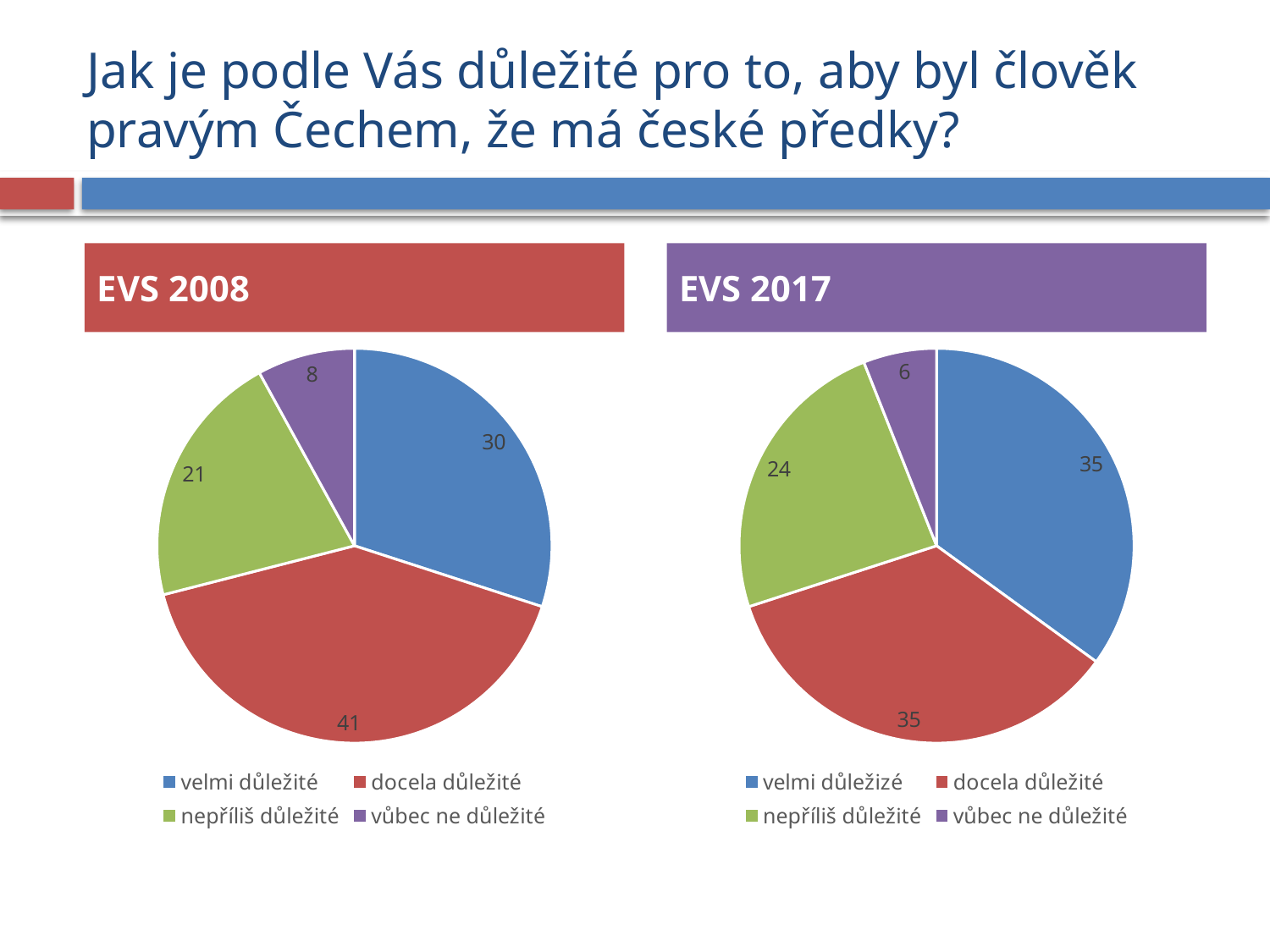
In the EVS 2008 chart, which category has the largest slice? docela důležité In the EVS 2008 chart, what is the difference between docela důležité and velmi důležité? 11 In the EVS 2008 chart, which category has the smallest slice? vůbec ne důležité In the EVS 2017 chart, what is the value for vůbec ne důležité? 6 In the EVS 2017 chart, what is the value for nepříliš důležité? 24 In the EVS 2017 chart, which category has the smallest slice? vůbec ne důležité What type of chart is the EVS 2008 chart? pie chart In the EVS 2008 chart, what is the value for docela důležité? 41 In the EVS 2008 chart, what is the value for vůbec ne důležité? 8 In the EVS 2008 chart, which is larger: nepříliš důležité or vůbec ne důležité? nepříliš důležité In the EVS 2017 chart, what is the difference between nepříliš důležité and vůbec ne důležité? 18 How many slices does the EVS 2017 pie chart have? 4